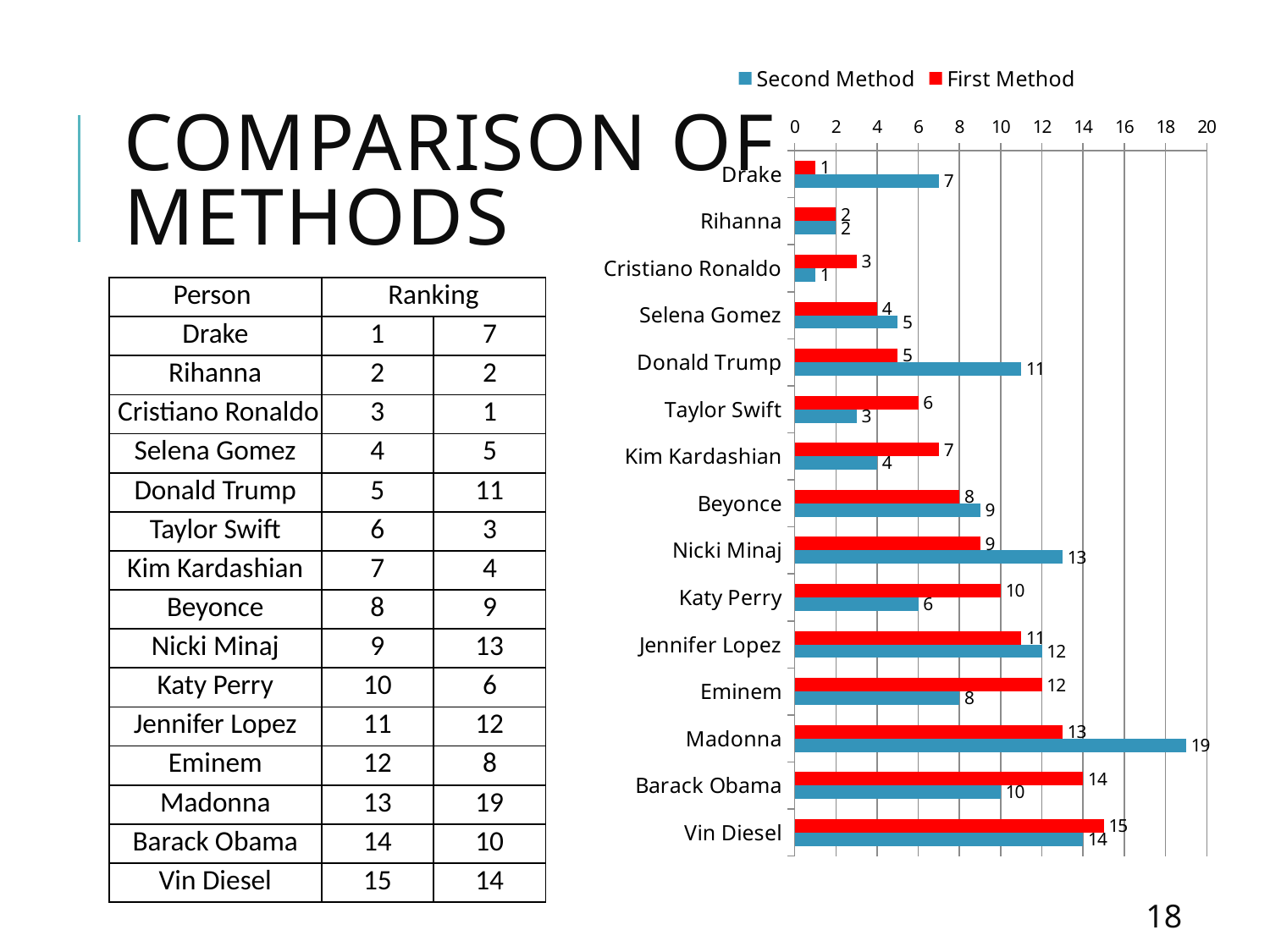
How many series does the chart legend list? 2 What type of chart is shown on the slide? bar chart Which person has the lowest First Method value? Drake What is the Second Method value for Katy Perry? 6 Which person has the highest Second Method value? Madonna What is the Second Method value for Madonna? 19 Is the Second Method value for Nicki Minaj greater or less than 10? greater How many people are plotted on the chart? 15 For Eminem, which is larger: the First Method value or the Second Method value? First Method What is the First Method value for Donald Trump? 5 What is the difference between the Second Method and First Method values for Donald Trump? 6 Which colour represents the First Method series in the chart? red